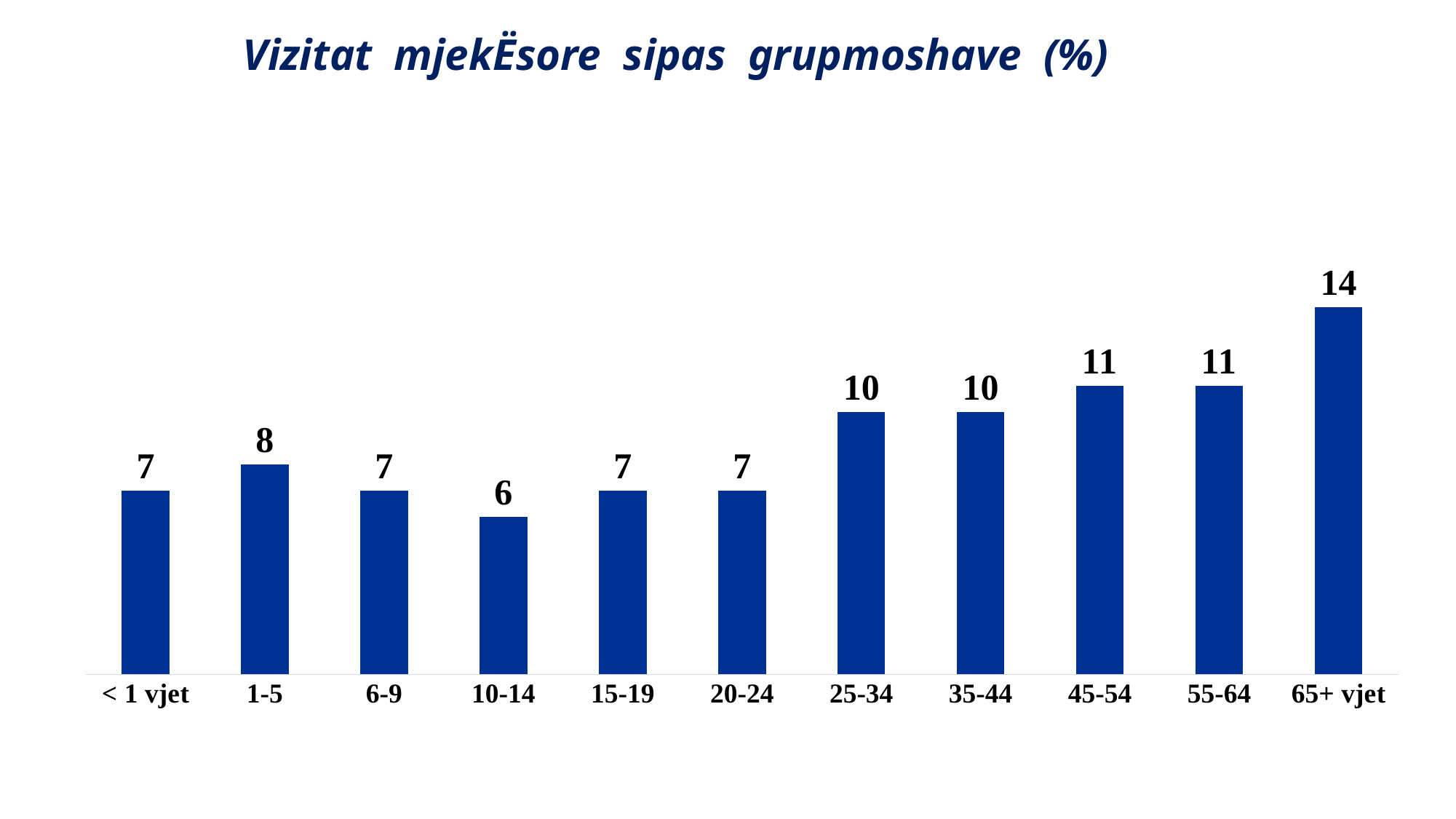
What is the value for the 1-5 age group? 8 Which age group has the lowest value? 10-14 Which age group has the highest value? 65+ vjet How many age groups are shown in the chart? 11 What kind of chart is shown on the slide? Bar chart What is the value for the 10-14 age group? 6 What is the value for the 65+ vjet age group? 14 What is the difference between the values for 25-34 and 1-5? 2 Which is larger, the value for 55-64 or the value for 20-24? 55-64 What is the difference between the values for 65+ vjet and 10-14? 8 What is the title of the chart? Vizitat mjekËsore sipas grupmoshave (%) What is the value for the 45-54 age group? 11